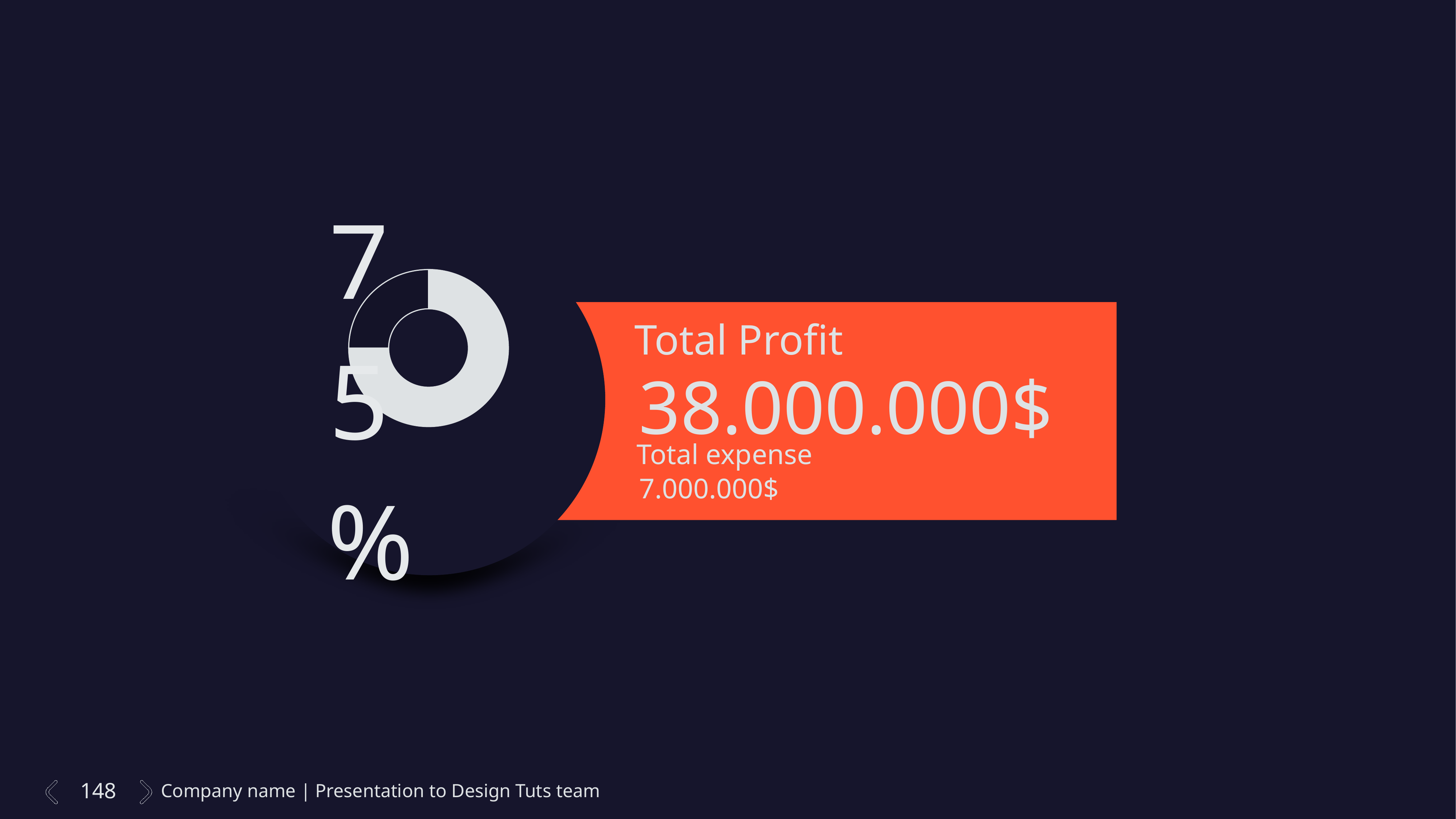
What is the Total Profit value shown beside the donut chart? 38.000.000$ Is the percentage shown with the donut chart greater or less than 50%? greater Is the filled (light) portion of the donut chart larger or smaller than the unfilled portion? larger How many segments does the donut chart have? 2 What percentage is displayed with the donut chart? 75% What kind of chart is shown on the slide? donut chart What is the Total expense value shown beside the donut chart? 7.000.000$